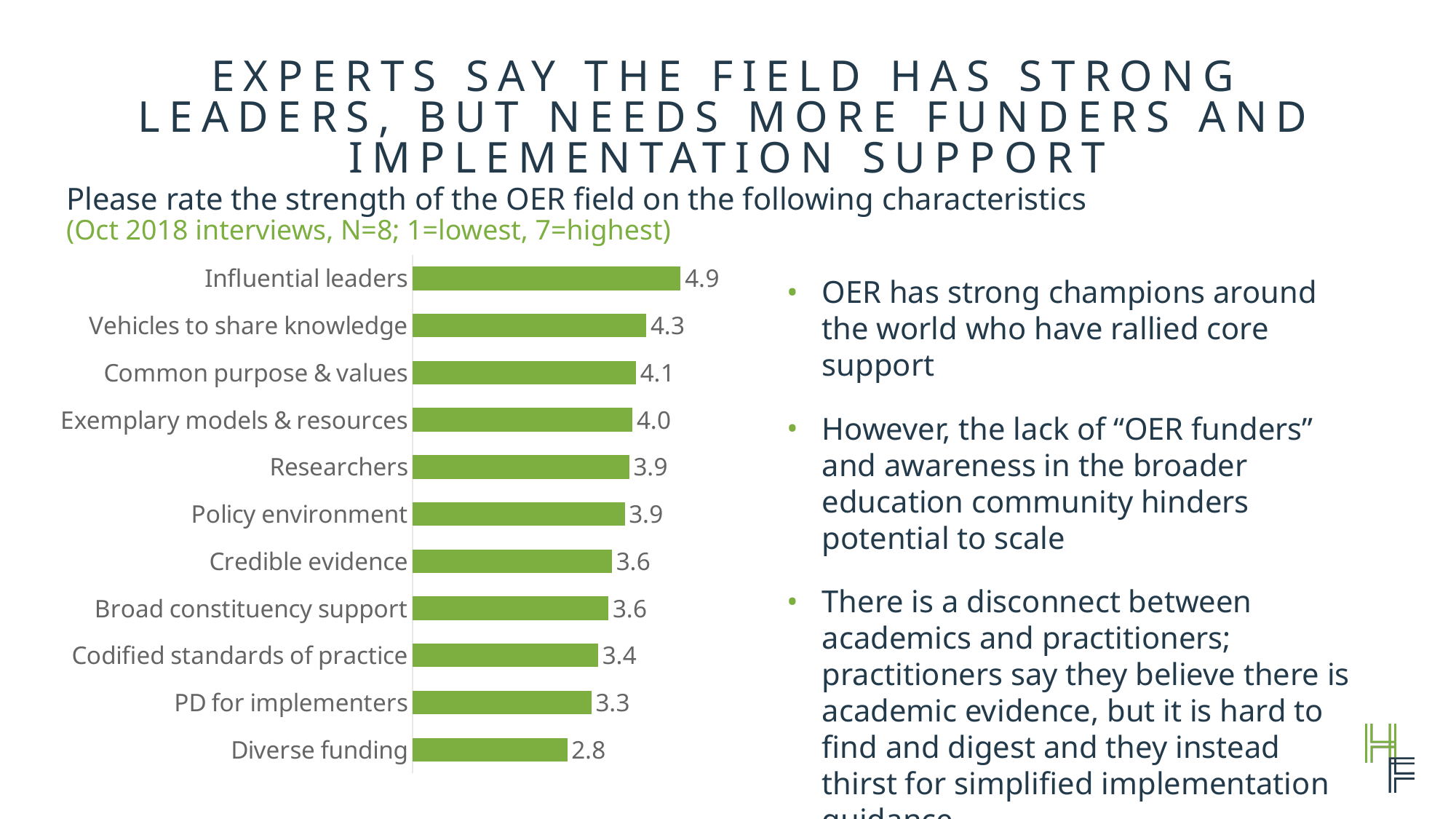
What is the difference between the ratings for Influential leaders and Diverse funding? 2.1 What kind of chart is shown on the slide? Bar chart What is the rating for Influential leaders? 4.9 Which has a higher rating, Exemplary models & resources or Credible evidence? Exemplary models & resources What is the rating for Vehicles to share knowledge? 4.3 What is the rating for Codified standards of practice? 3.4 How many characteristics are shown in the chart? 11 Which characteristic has the highest rating? Influential leaders What is the difference between the ratings for Common purpose & values and PD for implementers? 0.8 Which characteristic has the lowest rating? Diverse funding What colour are the bars in the chart? Green What is the rating for Diverse funding? 2.8